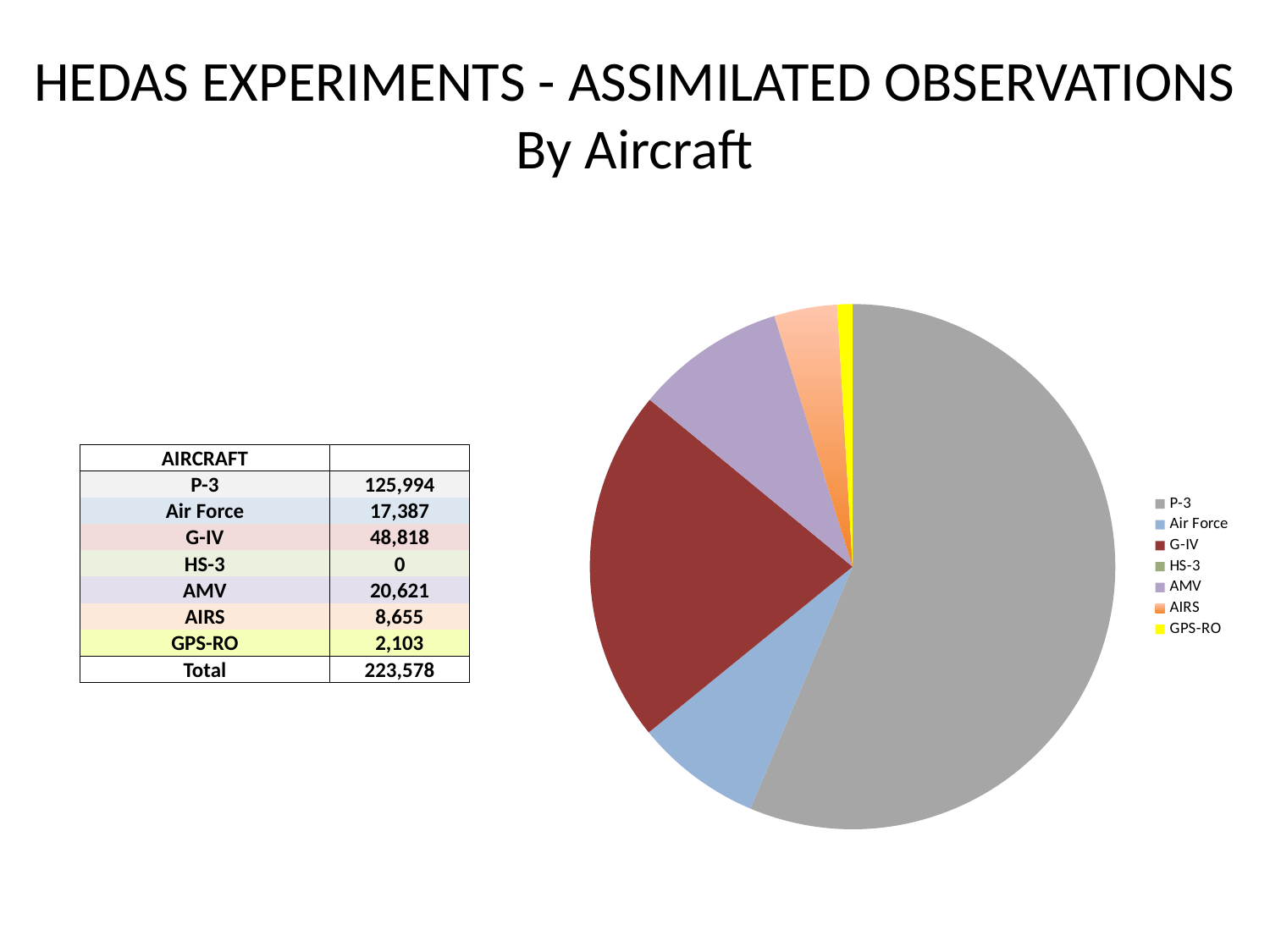
Which aircraft category has the largest share of the pie? P-3 What is the value for GPS-RO? 2,103 What is the value for G-IV? 48,818 How many entries does the pie chart legend list? 7 What is the value for AMV? 20,621 How many observations were assimilated from the P-3 aircraft? 125,994 What colour is the P-3 slice in the pie chart? grey What type of chart is shown on the slide? pie chart What is the difference between the G-IV and Air Force values? 31,431 Which is larger, the value for AMV or the value for Air Force? AMV Which category has the smallest value in the table? HS-3 What is the total number of assimilated observations across all aircraft? 223,578